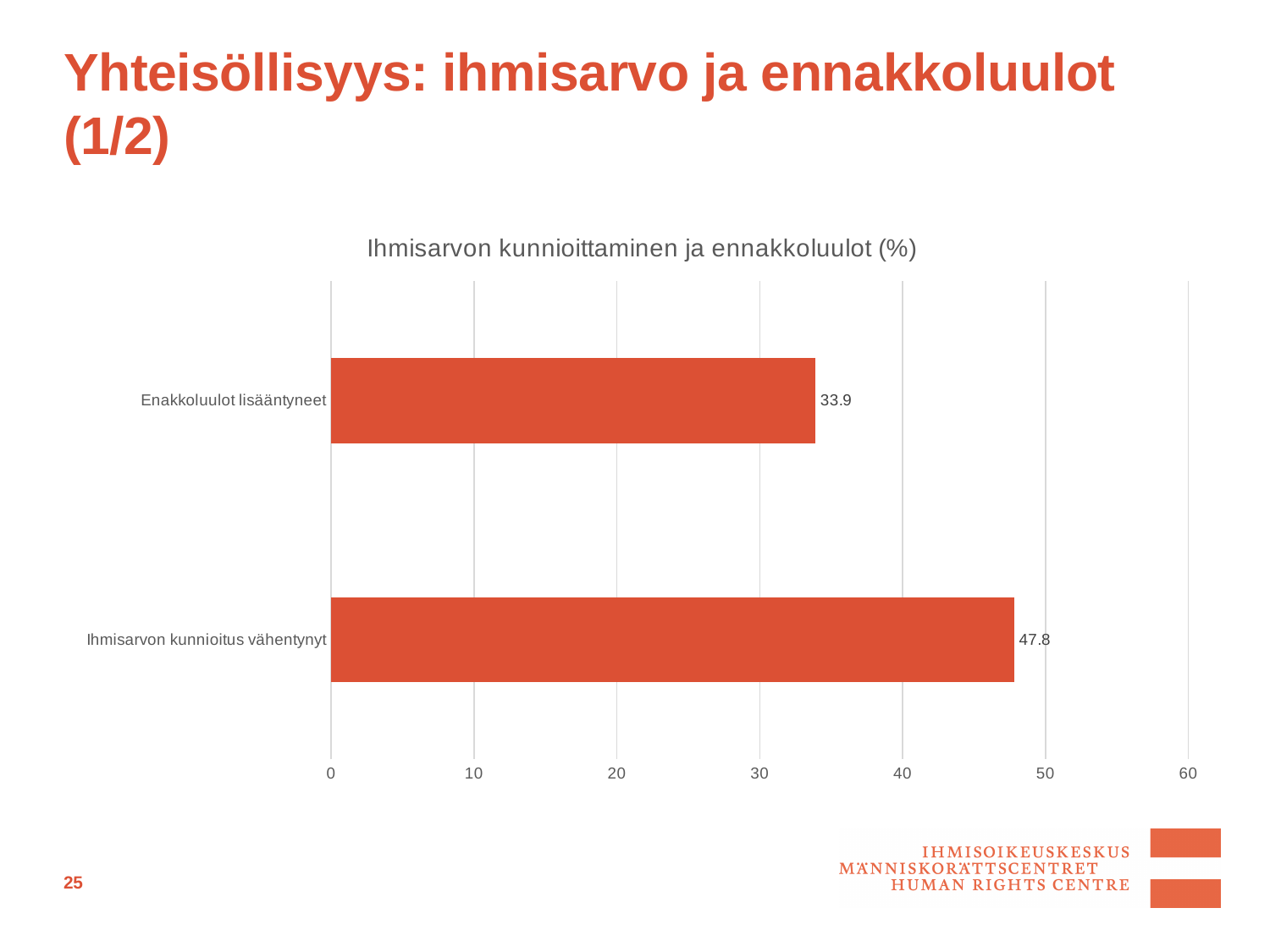
Is the value for "Ihmisarvon kunnioitus vähentynyt" greater or less than 40? greater What is the title of the chart? Ihmisarvon kunnioittaminen ja ennakkoluulot (%) Which is larger: the value for "Enakkoluulot lisääntyneet" or the value for "Ihmisarvon kunnioitus vähentynyt"? Ihmisarvon kunnioitus vähentynyt What is the maximum value shown on the horizontal axis of the chart? 60 Which category has the lowest value? Enakkoluulot lisääntyneet Which category has the highest value? Ihmisarvon kunnioitus vähentynyt How many categories are shown in the chart? 2 What is the difference between the values for "Ihmisarvon kunnioitus vähentynyt" and "Enakkoluulot lisääntyneet"? 13.9 What is the value for "Enakkoluulot lisääntyneet"? 33.9 What is the value for "Ihmisarvon kunnioitus vähentynyt"? 47.8 What kind of chart is shown on the slide? bar chart Is the value for "Enakkoluulot lisääntyneet" greater or less than 40? less